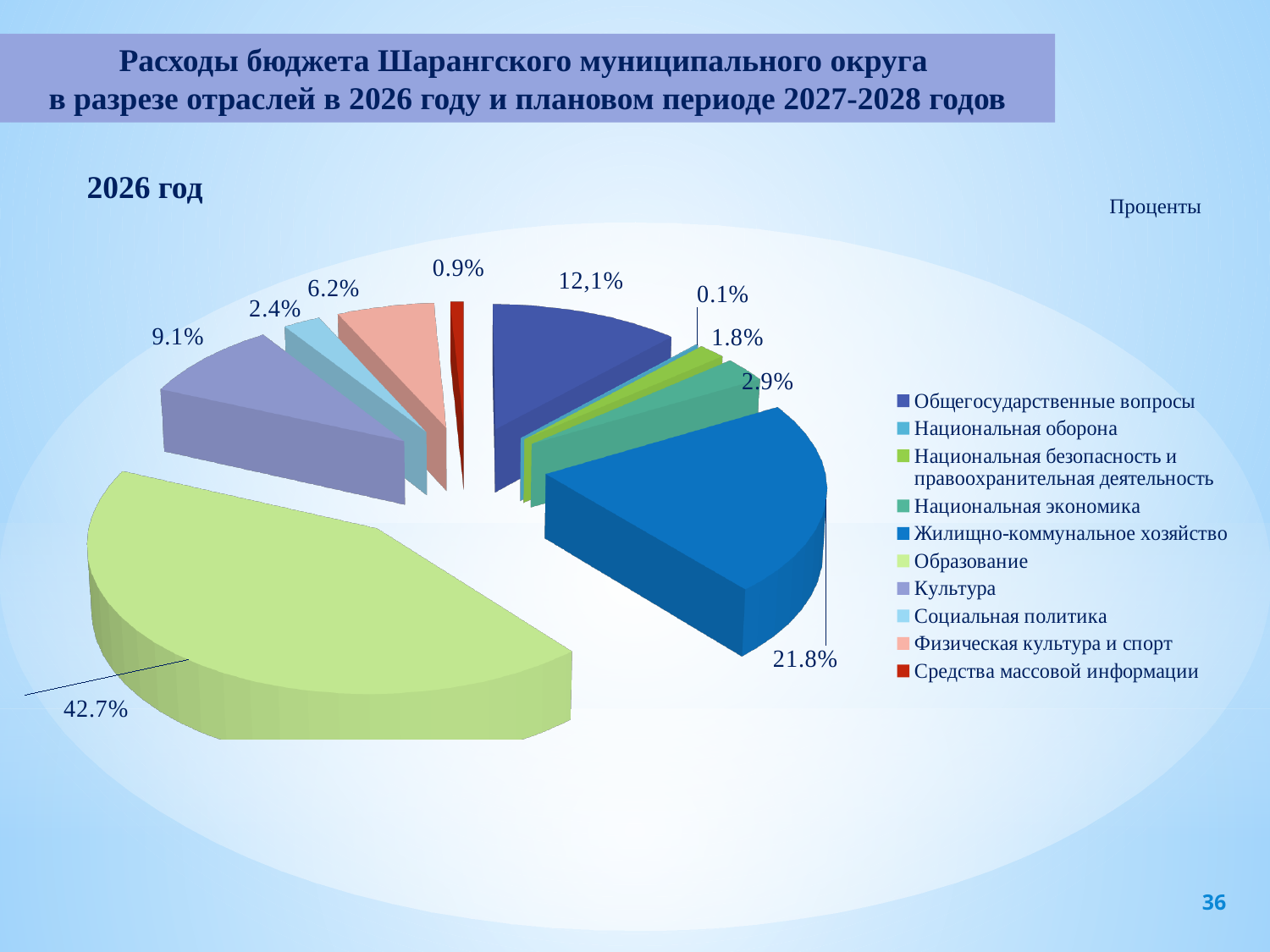
Which has a larger share of the 2026 budget: Культура or Физическая культура и спорт? Культура How many sectors are listed in the chart legend? 10 What share of the 2026 budget expenditures goes to Культура? 9.1% What share of the 2026 budget expenditures goes to Образование? 42.7% What is the difference in percentage points between the shares of Образование and Жилищно-коммунальное хозяйство? 20.9 What share of the 2026 budget expenditures goes to Жилищно-коммунальное хозяйство? 21.8% What kind of chart is shown on the slide? pie chart Which sector has the largest share of the 2026 budget expenditures? Образование What share of the 2026 budget expenditures goes to Национальная оборона? 0.1% What share of the 2026 budget expenditures goes to Общегосударственные вопросы? 12,1% What share of the 2026 budget expenditures goes to Физическая культура и спорт? 6.2% Which sector has the smallest share of the 2026 budget expenditures? Национальная оборона